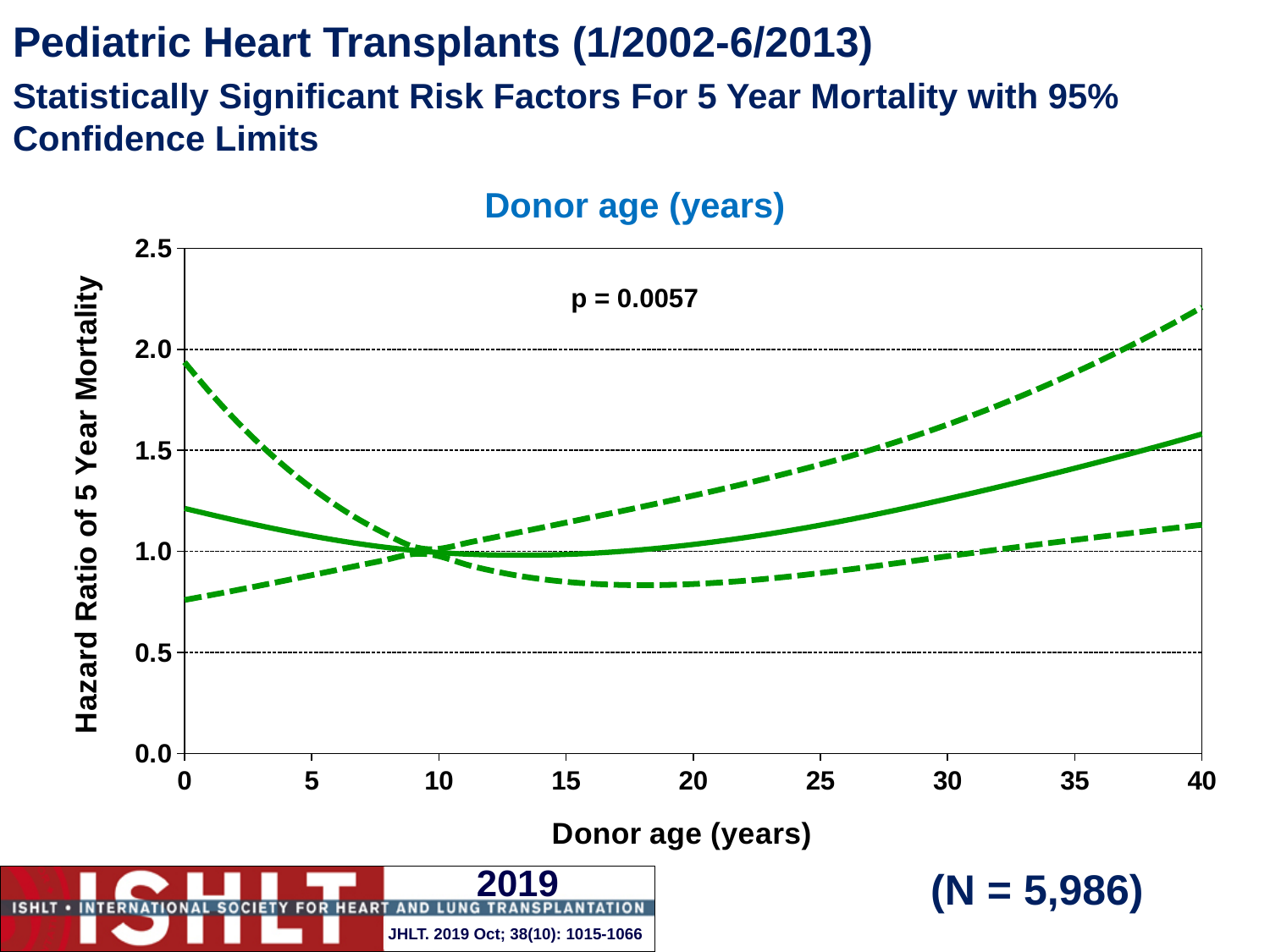
Does the solid line rise or fall between donor age 0 and donor age 10? fall How many lines are plotted on the chart? 3 What is the label of the y axis? Hazard Ratio of 5 Year Mortality Does the solid line rise or fall between donor age 20 and donor age 40? rise Is the value of the solid line at donor age 0 greater or less than 1.0? greater What is the title of the chart? Donor age (years) What kind of chart is shown on the slide? line chart Is the value of the upper dashed line at donor age 40 greater or less than 2.0? greater Is the value of the lower dashed line at donor age 0 greater or less than 1.0? less What p-value is printed on the chart? p = 0.0057 What sample size (N) is shown on the slide? N = 5,986